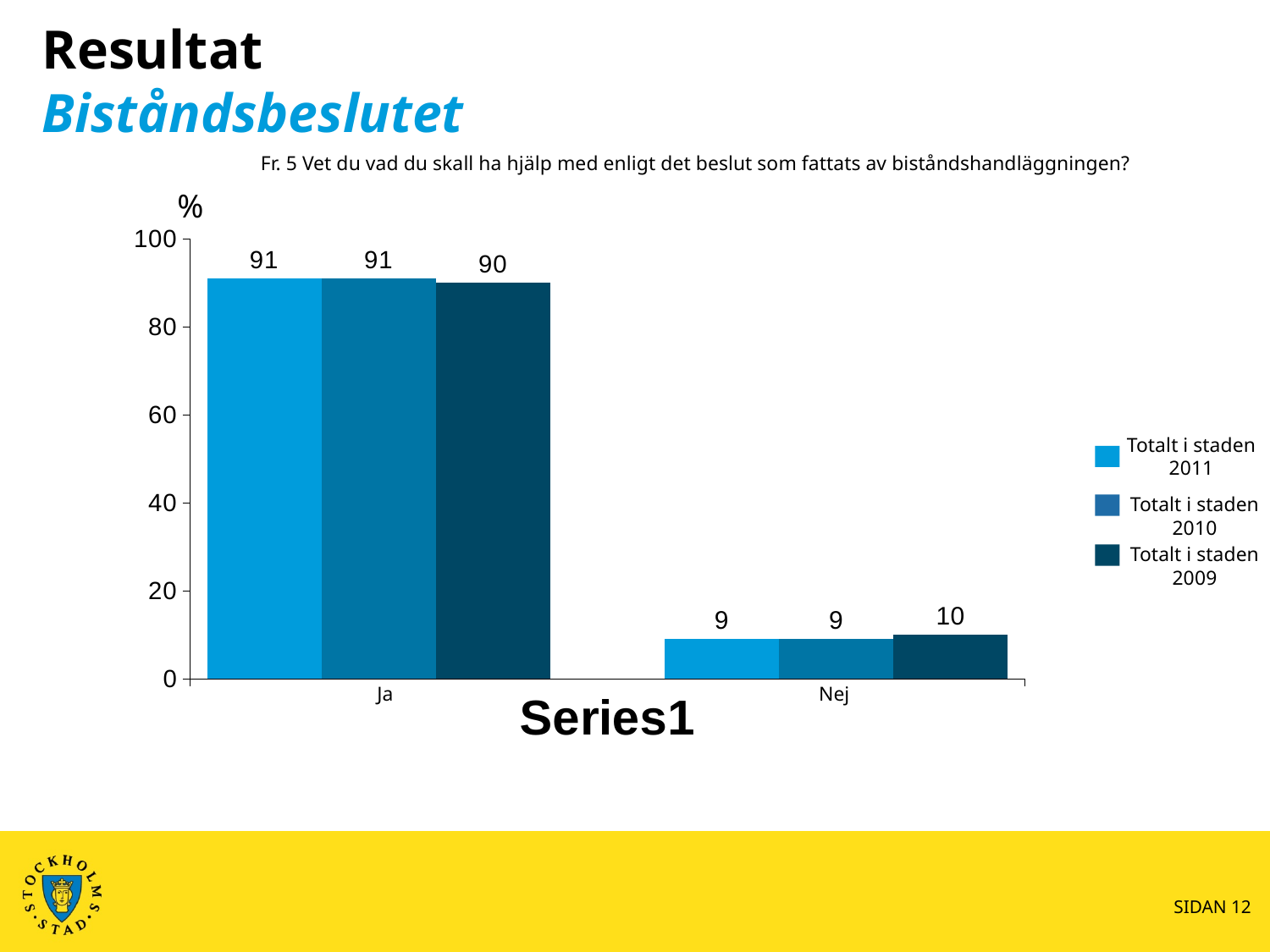
How many series does the legend list? 3 Which category has the highest value in the "Totalt i staden 2011" series? Ja What is the value for "Ja" in the "Totalt i staden 2009" series? 90 What unit is shown on the y axis of the chart? % What kind of chart is shown on the slide? bar chart Which category has the lowest value in the "Totalt i staden 2009" series? Nej Is the value for "Ja" in the "Totalt i staden 2010" series larger or smaller than the value for "Nej" in the same series? larger How many categories are shown on the x axis? 2 What is the value for "Ja" in the "Totalt i staden 2011" series? 91 What is the value for "Nej" in the "Totalt i staden 2009" series? 10 What is the difference between the "Ja" and "Nej" values in the "Totalt i staden 2011" series? 82 What is the value for "Nej" in the "Totalt i staden 2010" series? 9